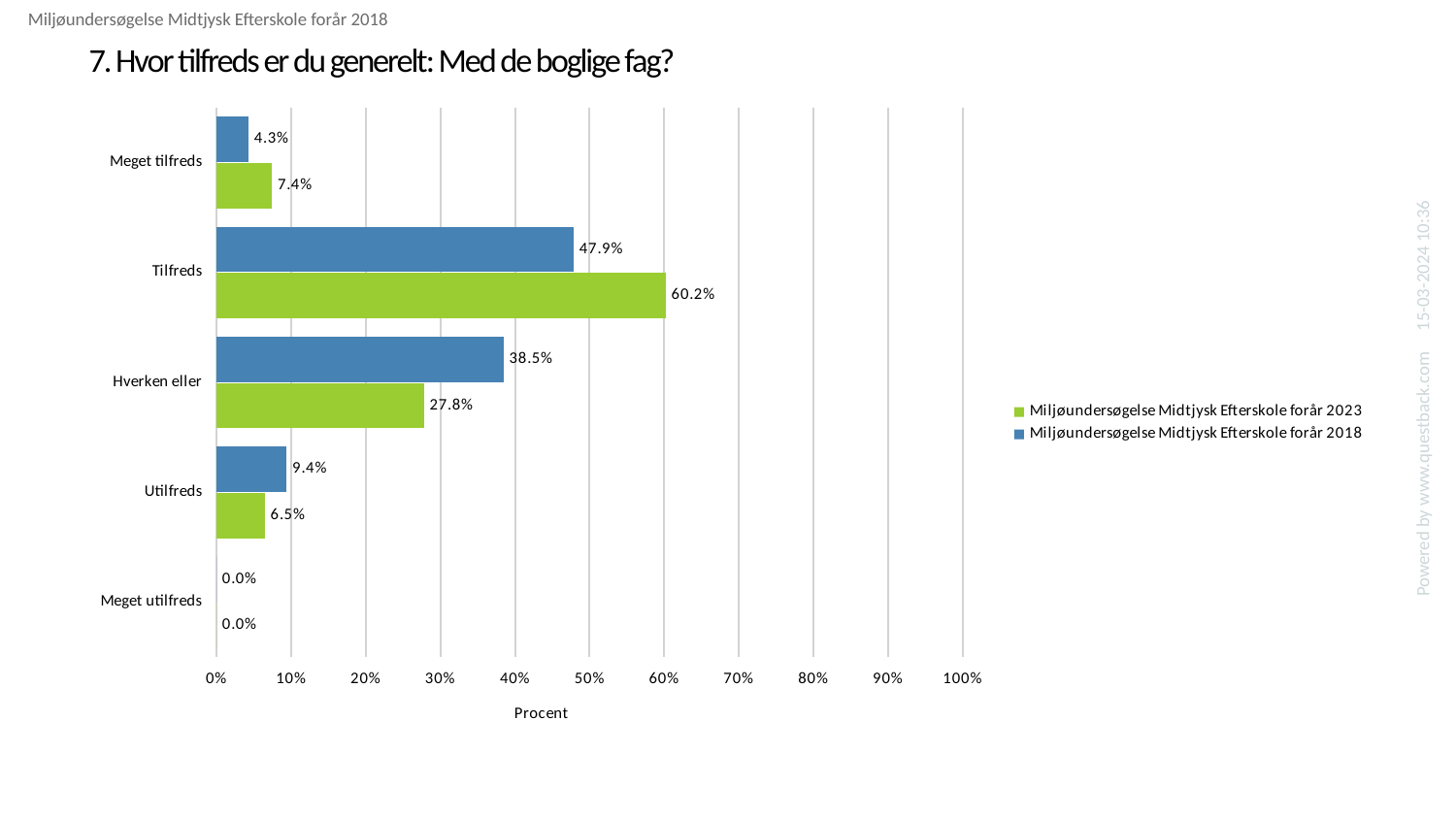
How many series does the legend list? 2 What kind of chart is shown on the slide? Bar chart Which series has the larger value for Hverken eller, 2023 or 2018? 2018 What is the difference between the 2023 and 2018 values for Tilfreds? 12.3% What is the value for Meget tilfreds in the 2018 series? 4.3% What is the value for Hverken eller in the Miljøundersøgelse Midtjysk Efterskole forår 2018 series? 38.5% Which category has the highest value in the 2023 series? Tilfreds Which category has the lowest value in the 2018 series? Meget utilfreds What is the label of the horizontal axis? Procent What is the value for Utilfreds in the 2023 series? 6.5% How many categories are shown on the chart? 5 What is the value for Tilfreds in the Miljøundersøgelse Midtjysk Efterskole forår 2023 series? 60.2%